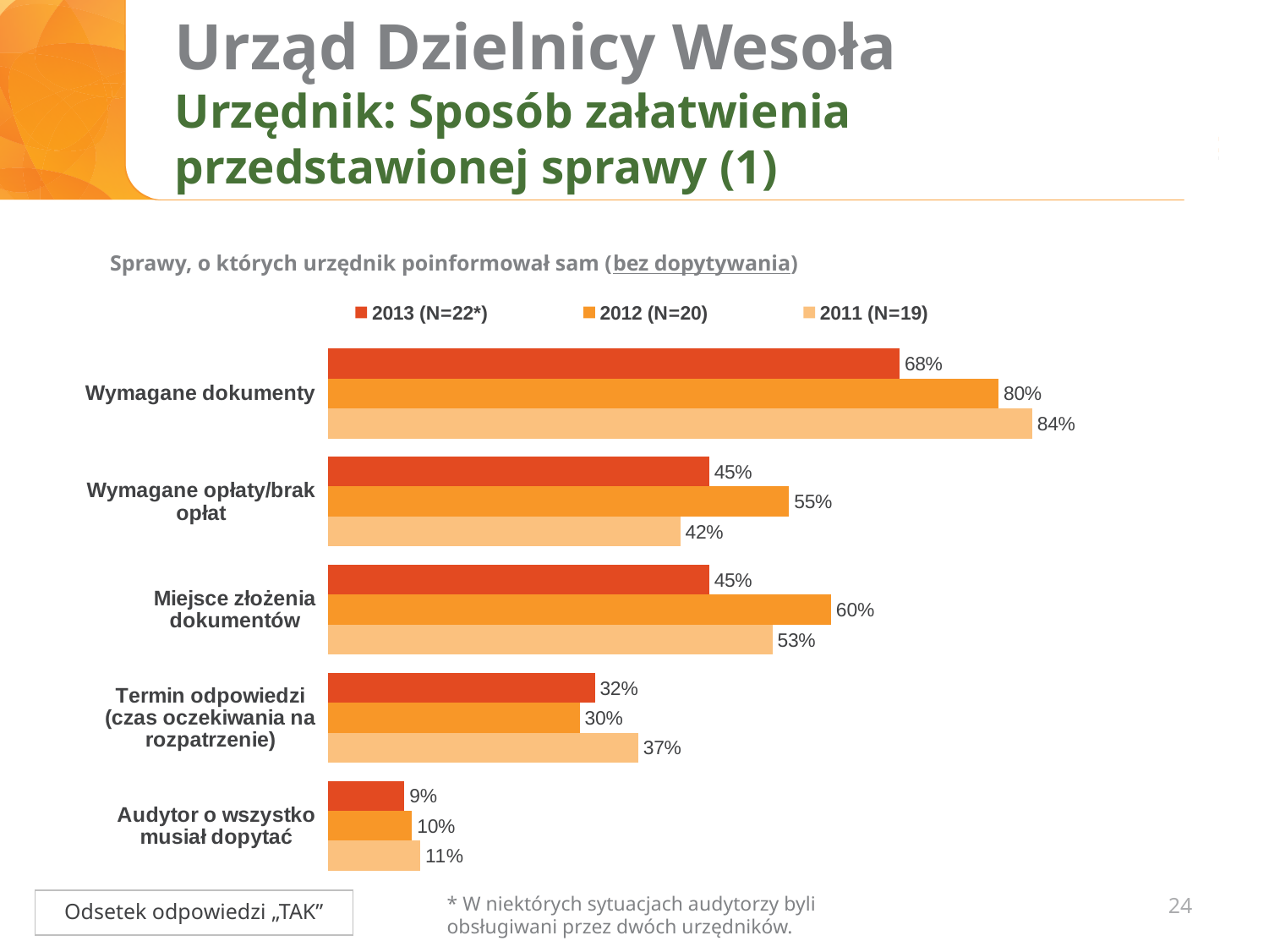
What is the value for 'Termin odpowiedzi (czas oczekiwania na rozpatrzenie)' in the 2011 (N=19) series? 37% Which is larger for 'Wymagane opłaty/brak opłat': the 2012 (N=20) value or the 2011 (N=19) value? 2012 (N=20) What is the difference between the 2011 (N=19) and 2013 (N=22*) values for 'Wymagane dokumenty'? 16% Which category has the highest value in the 2011 (N=19) series? Wymagane dokumenty What is the value for 'Wymagane dokumenty' in the 2013 (N=22*) series? 68% Which series is shown in the darkest red-orange colour in the legend? 2013 (N=22*) Which category has the lowest value in the 2013 (N=22*) series? Audytor o wszystko musiał dopytać What kind of chart is shown on the slide? bar chart How many categories are shown on the chart? 5 How many series does the legend list? 3 What is the difference between the 2012 (N=20) and 2013 (N=22*) values for 'Miejsce złożenia dokumentów'? 15% What is the value for 'Miejsce złożenia dokumentów' in the 2012 (N=20) series? 60%